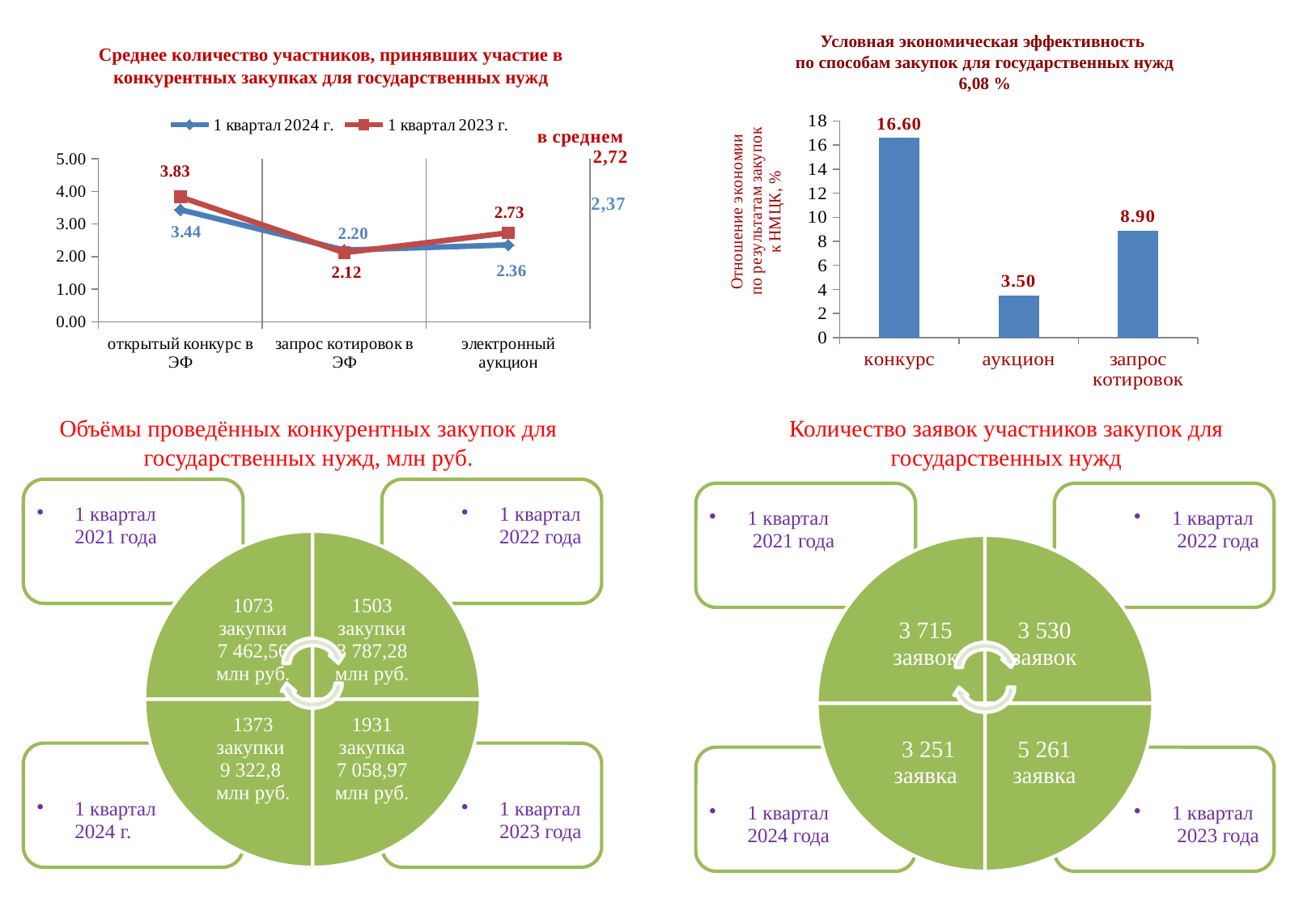
In the top-right chart 'Условная экономическая эффективность по способам закупок', which category has the lowest value? аукцион In the top-left line chart, how many series does the legend list? 2 In the top-left line chart, what is the value for 1 квартал 2024 г. for открытый конкурс в ЭФ? 3.44 In the top-left line chart, what is the value for 1 квартал 2023 г. for запрос котировок в ЭФ? 2.12 In the top-left line chart, what is the difference between the 1 квартал 2023 г. and 1 квартал 2024 г. values for открытый конкурс в ЭФ? 0.39 In the top-right chart 'Условная экономическая эффективность по способам закупок', how many categories are shown? 3 In the top-right chart 'Условная экономическая эффективность по способам закупок', what is the value for конкурс? 16.60 What kind of chart is the top-right chart 'Условная экономическая эффективность по способам закупок'? bar chart In the top-left line chart, what is the value for 1 квартал 2023 г. for электронный аукцион? 2.73 In the top-left line chart, which series has the larger value for запрос котировок в ЭФ? 1 квартал 2024 г. In the top-left line chart, which category has the highest value for 1 квартал 2023 г.? открытый конкурс в ЭФ In the top-right chart 'Условная экономическая эффективность по способам закупок', what is the difference between конкурс and запрос котировок? 7.70